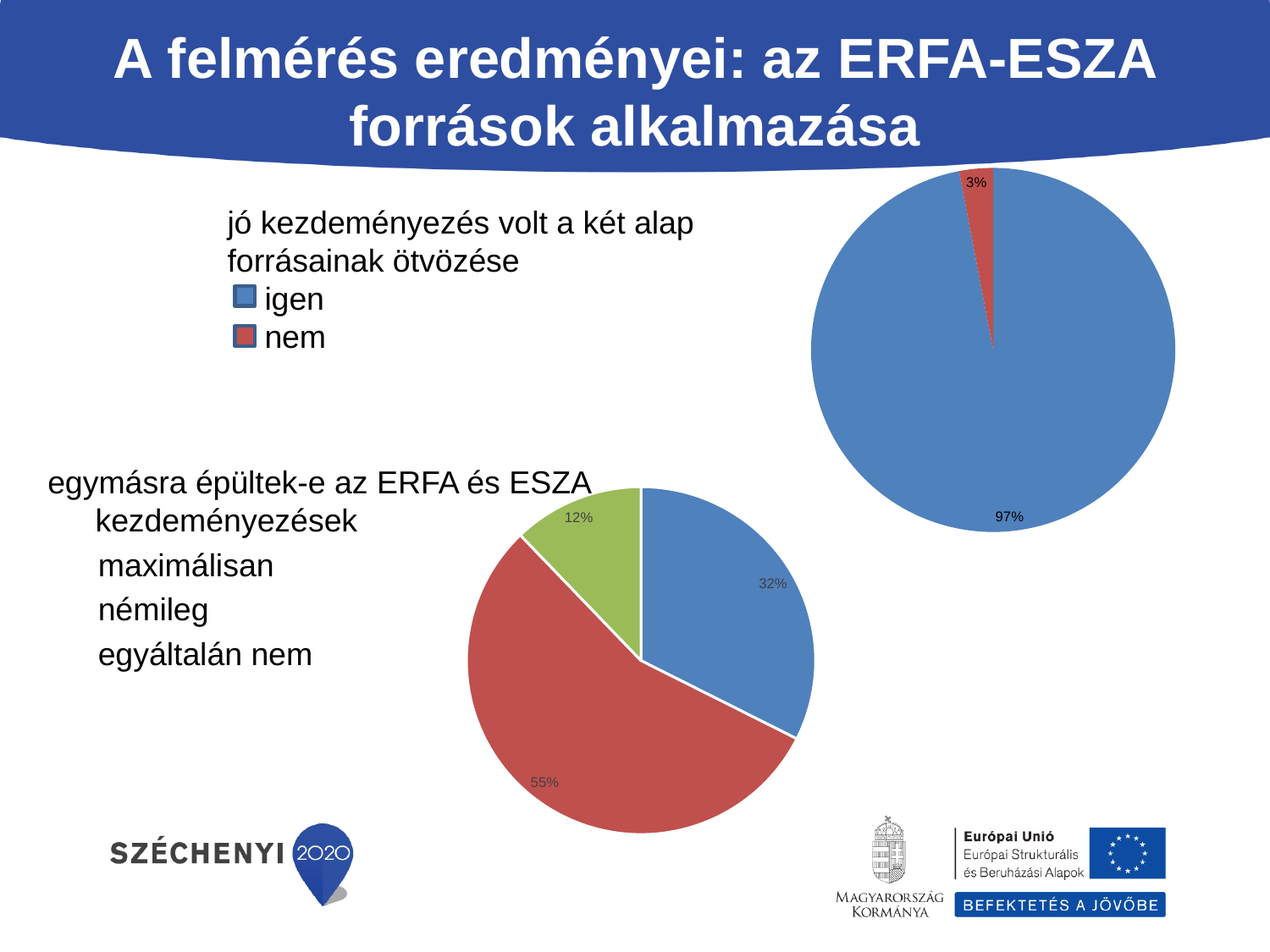
How many entries does the legend of the top-right pie chart ("jó kezdeményezés volt a két alap forrásainak ötvözése") list? 2 In the bottom pie chart ("egymásra épültek-e az ERFA és ESZA kezdeményezések"), what is the largest percentage shown? 55% In the top-right pie chart ("jó kezdeményezés volt a két alap forrásainak ötvözése"), which category has the largest slice? igen In the bottom pie chart ("egymásra épültek-e az ERFA és ESZA kezdeményezések"), which is larger, the blue slice or the green slice? the blue slice In the top-right pie chart ("jó kezdeményezés volt a két alap forrásainak ötvözése"), what share is labelled for "nem"? 3% In the top-right pie chart ("jó kezdeményezés volt a két alap forrásainak ötvözése"), what is the difference in percentage points between "igen" and "nem"? 94 What kind of chart is the top-right chart titled "jó kezdeményezés volt a két alap forrásainak ötvözése"? pie chart In the bottom pie chart ("egymásra épültek-e az ERFA és ESZA kezdeményezések"), what percentage is labelled on the red slice? 55% In the top-right pie chart ("jó kezdeményezés volt a két alap forrásainak ötvözése"), what colour is the "nem" slice? red How many slices does the bottom pie chart ("egymásra épültek-e az ERFA és ESZA kezdeményezések") have? 3 In the top-right pie chart ("jó kezdeményezés volt a két alap forrásainak ötvözése"), what share is labelled for "igen"? 97% In the bottom pie chart ("egymásra épültek-e az ERFA és ESZA kezdeményezések"), what percentage is labelled on the green slice? 12%